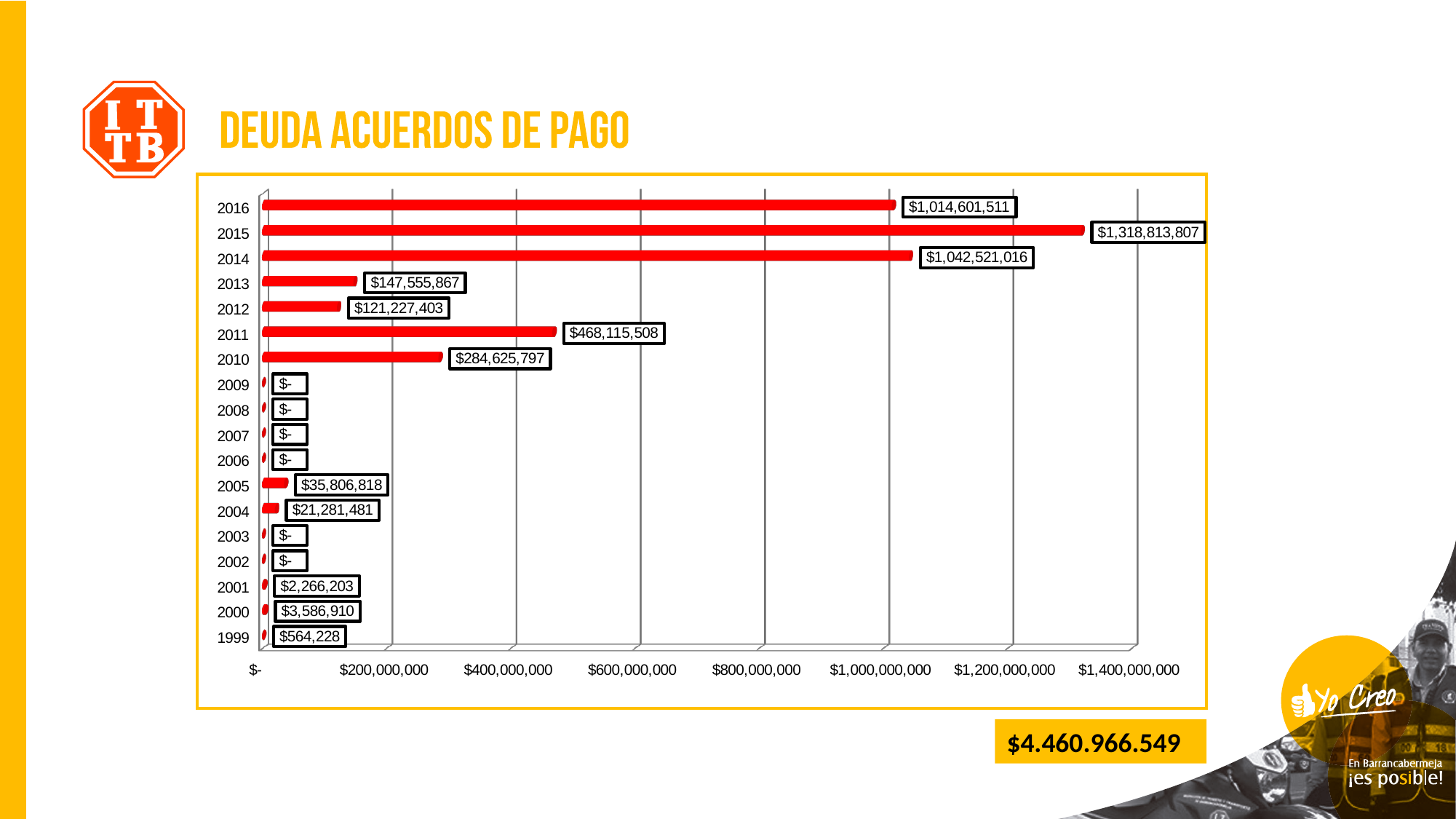
What is the value for 2015? $1,318,813,807 Which is larger, the value for 2013 or the value for 2012? 2013 What is the difference between the values for 2015 and 2014? $276,292,791 How many years are shown on the chart? 18 What kind of chart is shown? bar chart How many years show a value of $-? 6 Is the value for 2014 greater or less than $1,000,000,000? greater What is the value for 2005? $35,806,818 What is the value for 1999? $564,228 What is the value for 2011? $468,115,508 Which year has the highest value? 2015 What is the difference between the values for 2011 and 2010? $183,489,711